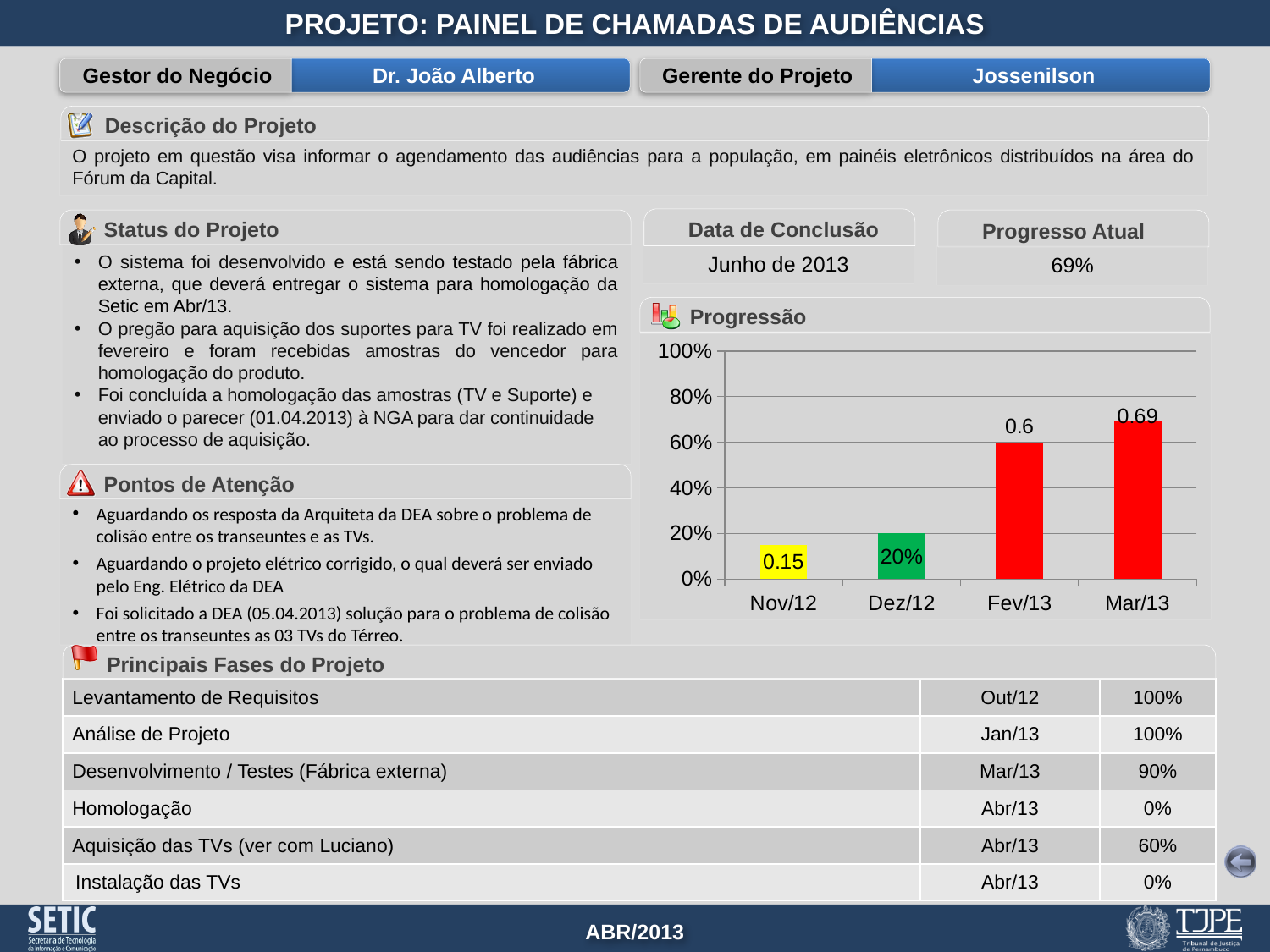
In the "Progressão" chart, what is the value for Dez/12? 20% In the "Progressão" chart, is the value for Fev/13 greater or less than 40%? greater In the "Progressão" chart, which month has the lowest value? Nov/12 How many months are shown on the x axis of the "Progressão" chart? 4 In the "Progressão" chart, do the values rise or fall from Nov/12 to Mar/13? rise In the "Progressão" chart, what is the value for Mar/13? 0.69 In the "Progressão" chart, what is the value for Nov/12? 0.15 What type of chart is shown under "Progressão"? bar chart In the "Progressão" chart, what is the value for Fev/13? 0.6 In the "Progressão" chart, which is larger, the value for Fev/13 or the value for Dez/12? Fev/13 In the "Progressão" chart, which month has the highest value? Mar/13 In the "Progressão" chart, what is the difference between the values for Mar/13 and Fev/13? 0.09